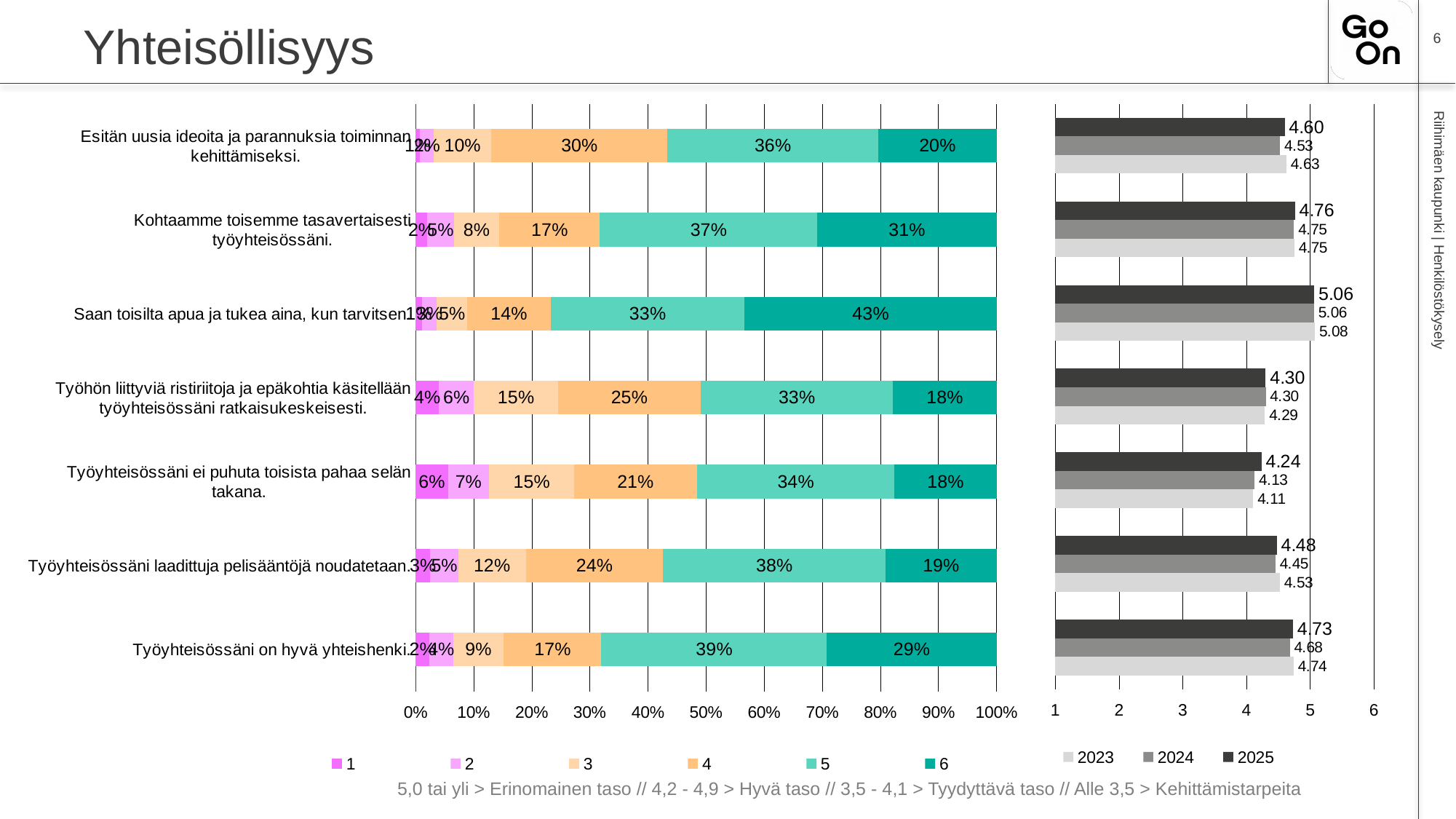
In the left stacked bar chart, which statement has a larger share of rating 6: "Kohtaamme toisemme tasavertaisesti työyhteisössäni." or "Työyhteisössäni on hyvä yhteishenki."? Kohtaamme toisemme tasavertaisesti työyhteisössäni. In the left stacked bar chart, what percentage gave a rating of 4 for "Työhön liittyviä ristiriitoja ja epäkohtia käsitellään työyhteisössäni ratkaisukeskeisesti."? 25% In the left stacked bar chart, what is the difference between the rating 5 share and the rating 6 share for "Työyhteisössäni laadittuja pelisääntöjä noudatetaan."? 19% In the right bar chart, how much higher is the 2025 average than the 2023 average for "Työyhteisössäni ei puhuta toisista pahaa selän takana."? 0.13 In the right bar chart, which statement has the highest 2025 average? Saan toisilta apua ja tukea aina, kun tarvitsen. How many statements (categories) are shown in the left stacked bar chart? 7 What type of chart is the left chart on the slide? Stacked bar chart How many series does the legend of the right bar chart list? 3 In the right bar chart, what is the 2025 average for "Työyhteisössäni ei puhuta toisista pahaa selän takana."? 4.24 In the left stacked bar chart, what percentage gave a rating of 5 for "Työyhteisössäni on hyvä yhteishenki."? 39% In the left stacked bar chart, what percentage of respondents gave a rating of 6 for "Saan toisilta apua ja tukea aina, kun tarvitsen."? 43% In the right bar chart, which statement has the lowest 2025 average? Työyhteisössäni ei puhuta toisista pahaa selän takana.